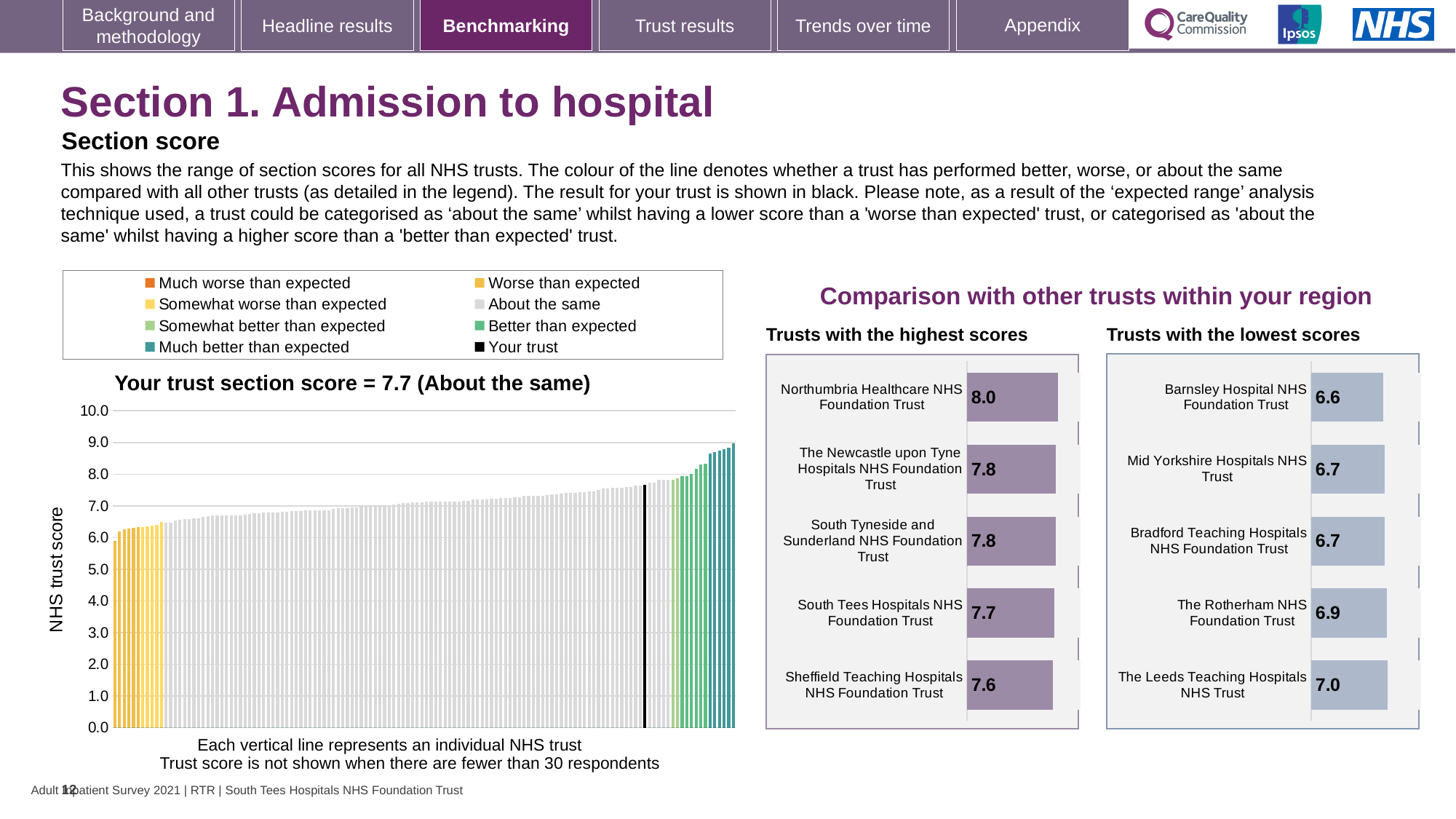
In the 'Trusts with the highest scores' chart, what is the difference between the scores of Northumbria Healthcare NHS Foundation Trust and Sheffield Teaching Hospitals NHS Foundation Trust? 0.4 In the 'Your trust section score' chart, do the trust scores rise or fall from left to right? Rise How many entries does the legend above the 'Your trust section score' chart list? 8 In the 'Trusts with the lowest scores' chart, which trust has the lowest score? Barnsley Hospital NHS Foundation Trust In the 'Trusts with the lowest scores' chart, which has the larger score: The Rotherham NHS Foundation Trust or The Leeds Teaching Hospitals NHS Trust? The Leeds Teaching Hospitals NHS Trust In the 'Trusts with the highest scores' chart, what is the score for Northumbria Healthcare NHS Foundation Trust? 8.0 What kind of chart is the 'Your trust section score' chart? Bar chart How many trusts are listed in the 'Trusts with the highest scores' chart? 5 In the 'Trusts with the lowest scores' chart, what is the difference between the scores of The Leeds Teaching Hospitals NHS Trust and Barnsley Hospital NHS Foundation Trust? 0.4 In the 'Trusts with the highest scores' chart, which trust has the highest score? Northumbria Healthcare NHS Foundation Trust In the 'Your trust section score' chart, what is the section score for your trust? 7.7 In the 'Trusts with the lowest scores' chart, what is the score for Barnsley Hospital NHS Foundation Trust? 6.6